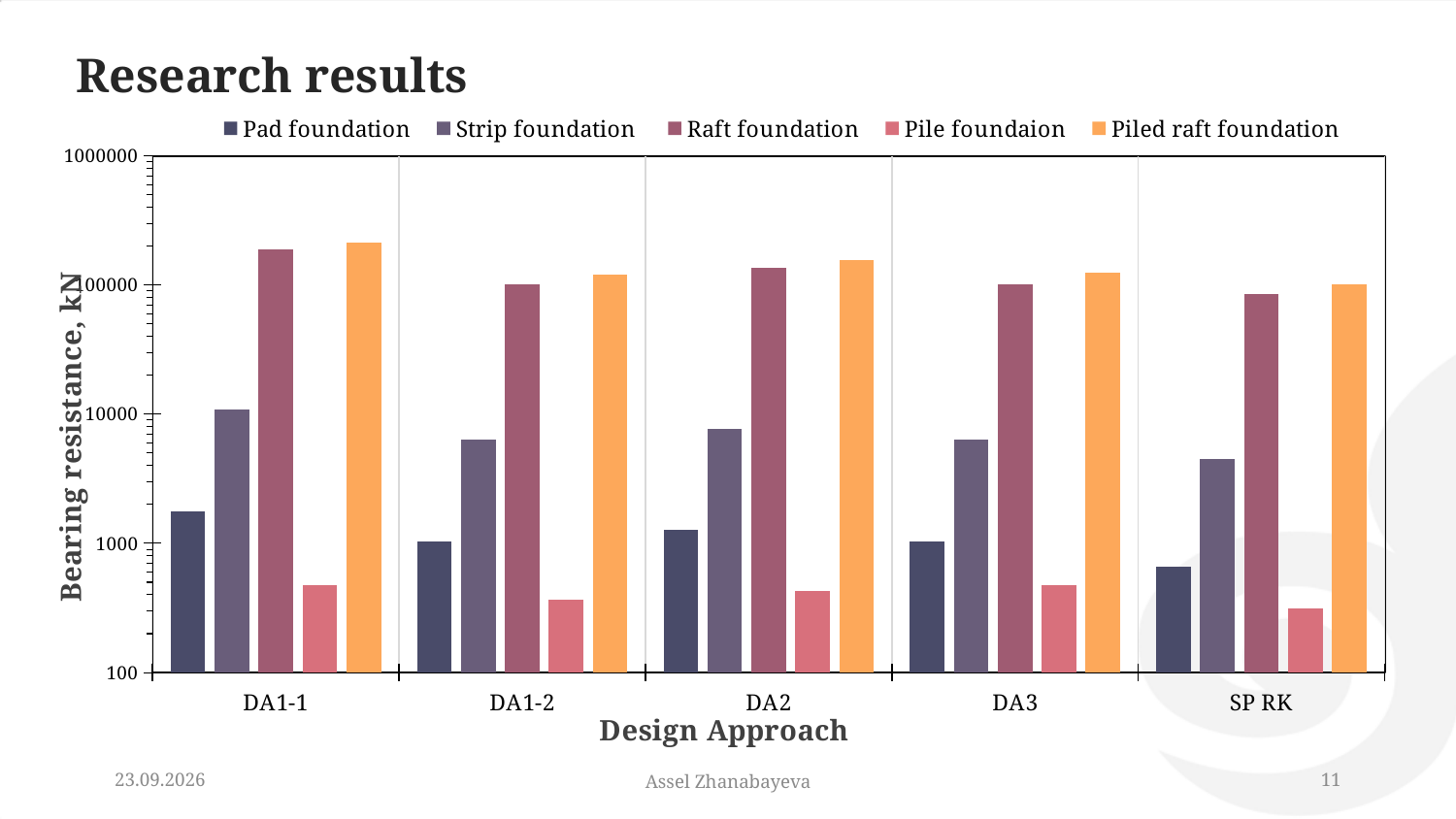
Is the value for Pad foundation at DA1-1 greater or less than 1000? greater Which foundation type has the lowest bearing resistance for DA1-1? Pile foundaion Which foundation type has the highest bearing resistance for DA1-1? Piled raft foundation What is the title of the y axis? Bearing resistance, kN How many series does the legend list? 5 What kind of chart is shown on the slide? bar chart Is the value for Strip foundation at SP RK greater or less than 10000? less How many design approaches (categories) are shown on the x axis? 5 For DA2, which is larger: Raft foundation or Strip foundation? Raft foundation For which design approach is the Pad foundation bar the lowest? SP RK Is the value for Raft foundation at DA1-1 greater or less than 100000? greater